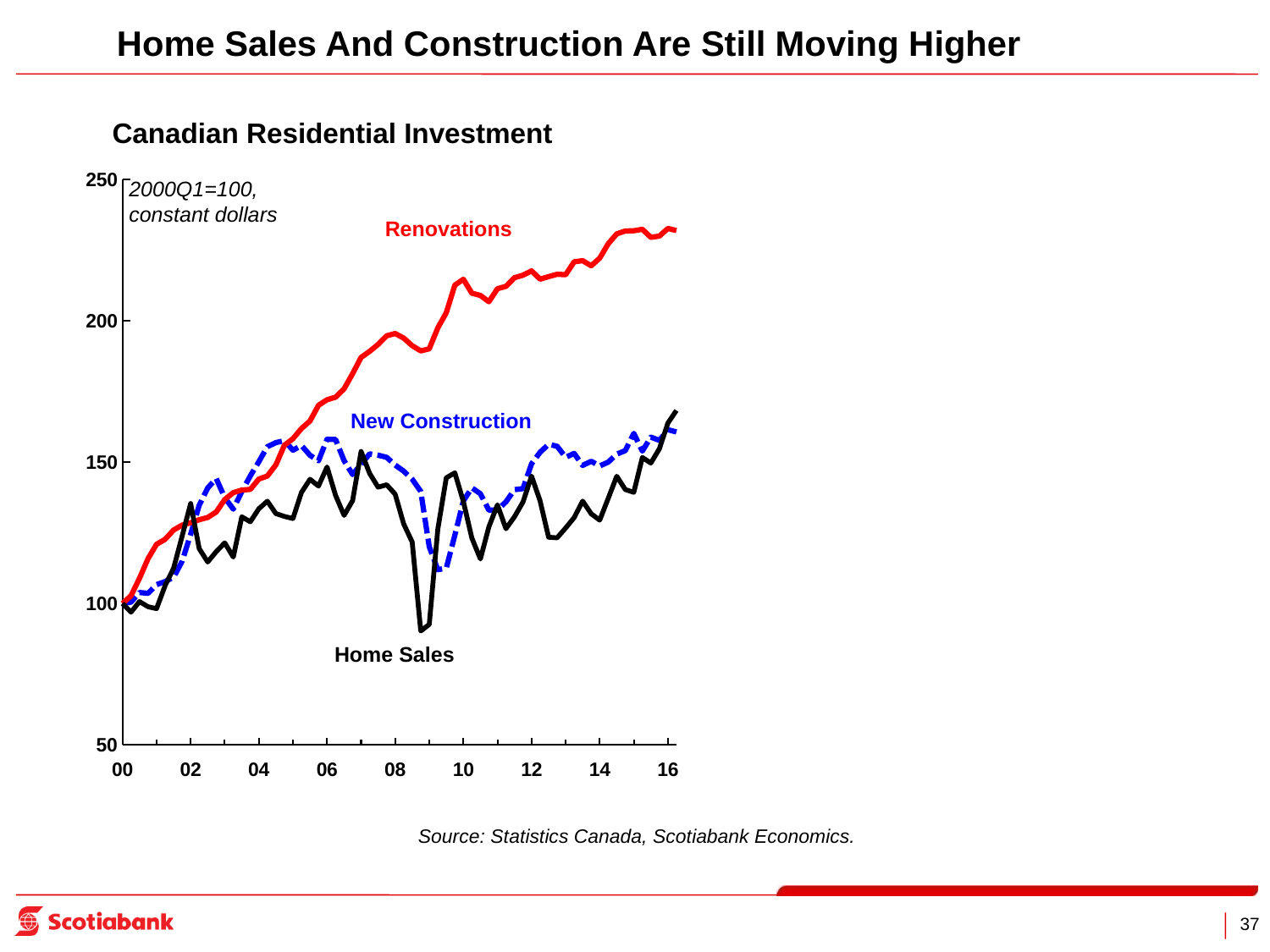
What is the title of the chart? Canadian Residential Investment Is the lowest value for Home Sales around 2009 greater or less than 100? less What colour is the Renovations line? red How many series are plotted on the chart? 3 In 2016, which is larger: Renovations or Home Sales? Renovations Is the value for New Construction in 2016 greater or less than 150? greater What kind of chart is shown on the slide? line chart Is the value for Renovations in 2016 greater or less than 200? greater Does the Renovations series generally rise or fall from 2000 to 2016? rise Which series has the lowest value around 2009? Home Sales Which series has the highest value at the end of the period (2016)? Renovations